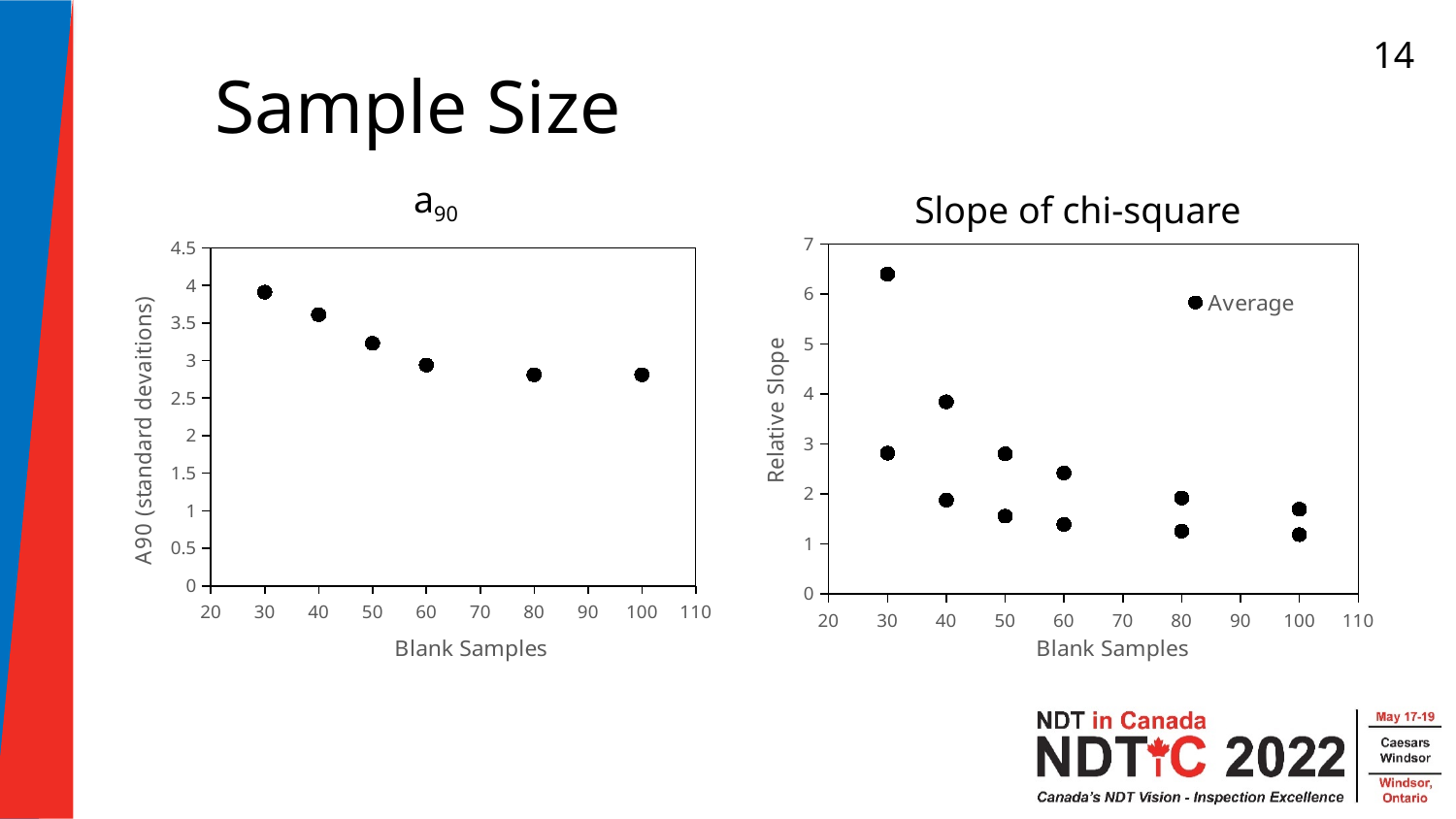
How many data points are plotted in the left chart titled a90? 6 In the left chart titled a90, at which number of Blank Samples is the plotted value highest? 30 How many series does the legend list in the right chart titled Slope of chi-square? 1 In the left chart titled a90, is the value at 30 Blank Samples greater or less than 3.5? greater In the right chart titled Slope of chi-square, is the lower point at 100 Blank Samples greater or less than 2? less In the right chart titled Slope of chi-square, at which number of Blank Samples is the highest plotted value found? 30 What is the y-axis label of the left chart titled a90? A90 (standard devaitions) What is the x-axis label of the right chart titled Slope of chi-square? Blank Samples In the right chart titled Slope of chi-square, is the highest point at 30 Blank Samples greater or less than 6? greater In the left chart titled a90, do the values rise or fall as Blank Samples increases? fall What kind of chart is the left chart titled a90? scatter chart